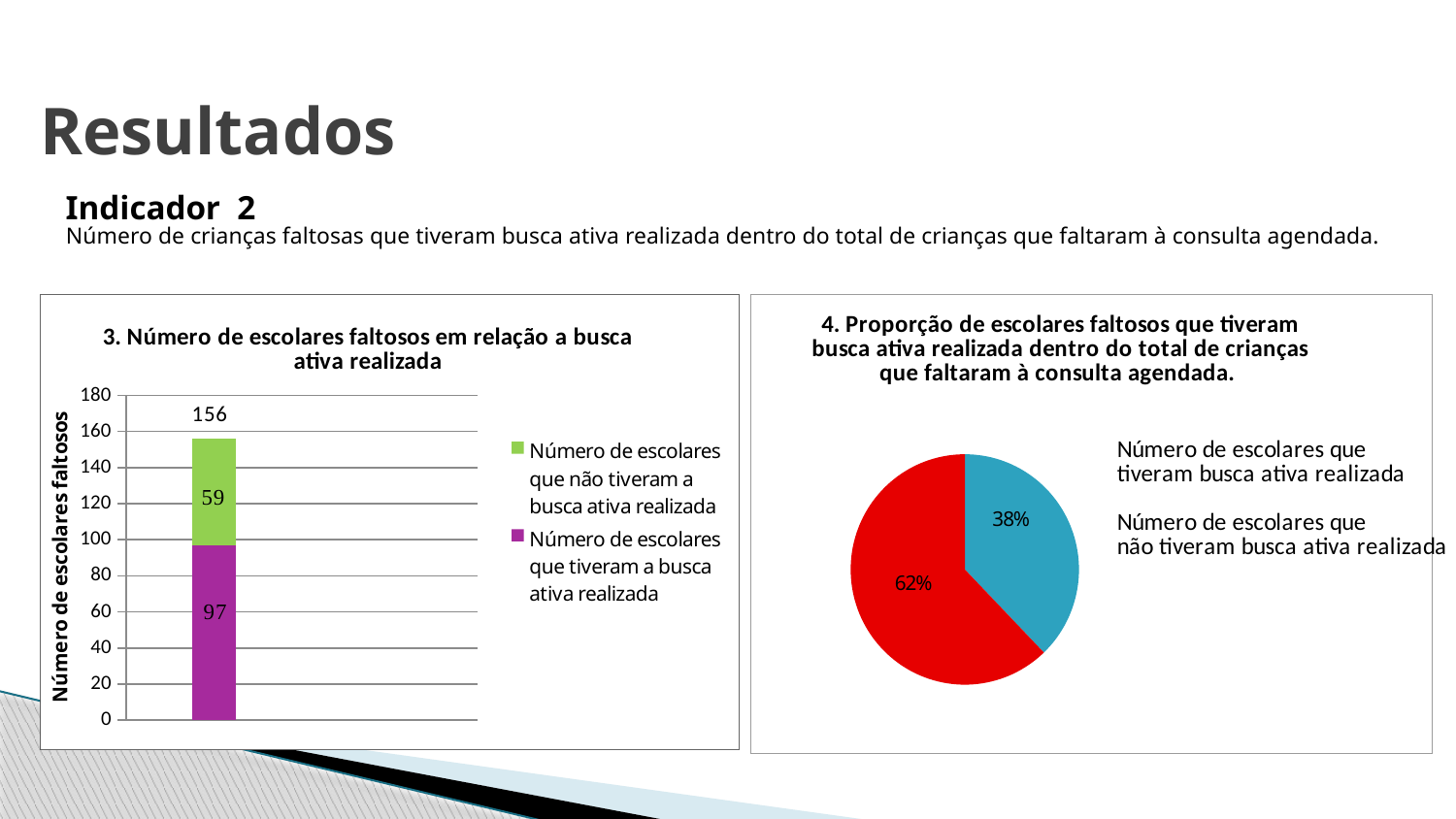
In the left chart ("3. Número de escolares faltosos em relação a busca ativa realizada"), is the value for students who had busca ativa realizada greater or less than 80? greater In the right chart ("4. Proporção de escolares faltosos que tiveram busca ativa realizada..."), what share does the blue slice represent? 38% In the left chart ("3. Número de escolares faltosos em relação a busca ativa realizada"), which series has the larger value: students who had busca ativa realizada or students who did not? Número de escolares que tiveram a busca ativa realizada In the left chart ("3. Número de escolares faltosos em relação a busca ativa realizada"), what is the value for "Número de escolares que tiveram a busca ativa realizada"? 97 In the left chart ("3. Número de escolares faltosos em relação a busca ativa realizada"), what is the difference between the number of students who had busca ativa realizada and those who did not? 38 How many series does the legend of the left chart ("3. Número de escolares faltosos em relação a busca ativa realizada") list? 2 What is the y-axis title of the left chart ("3. Número de escolares faltosos em relação a busca ativa realizada")? Número de escolares faltosos In the left chart ("3. Número de escolares faltosos em relação a busca ativa realizada"), what is the value for "Número de escolares que não tiveram a busca ativa realizada"? 59 In the right chart ("4. Proporção de escolares faltosos que tiveram busca ativa realizada..."), what share does the red slice represent? 62% In the left chart ("3. Número de escolares faltosos em relação a busca ativa realizada"), what is the total of the stacked bar? 156 What kind of chart is the right chart ("4. Proporção de escolares faltosos que tiveram busca ativa realizada...")? Pie chart What kind of chart is the left chart ("3. Número de escolares faltosos em relação a busca ativa realizada")? Stacked bar chart